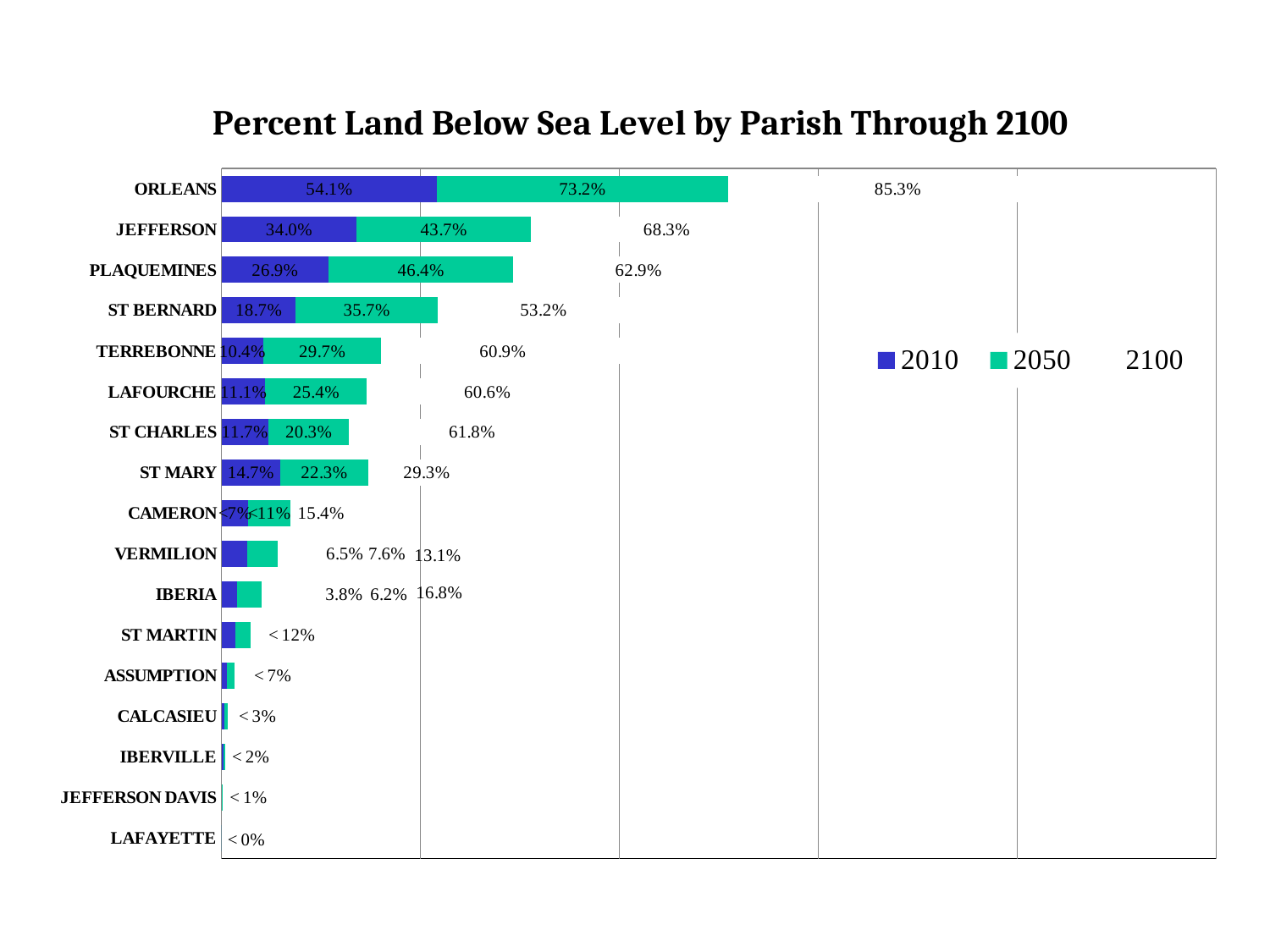
What kind of chart is shown on the slide? Bar chart Which is larger, the 2050 value for Plaquemines or the 2050 value for Jefferson? Plaquemines What is the 2050 value for St Bernard? 35.7% What is the 2050 value for Plaquemines? 46.4% What is the 2100 value for Terrebonne? 60.9% What is the difference between the 2050 and 2010 values for Jefferson? 9.7 percentage points Which parish has the highest 2100 value? Orleans What is the difference between the 2100 and 2010 values for Orleans? 31.2 percentage points Which parish has the highest 2010 value? Orleans What is the 2010 value for Orleans? 54.1% How many parishes are listed on the chart? 17 How many series does the legend list? 3